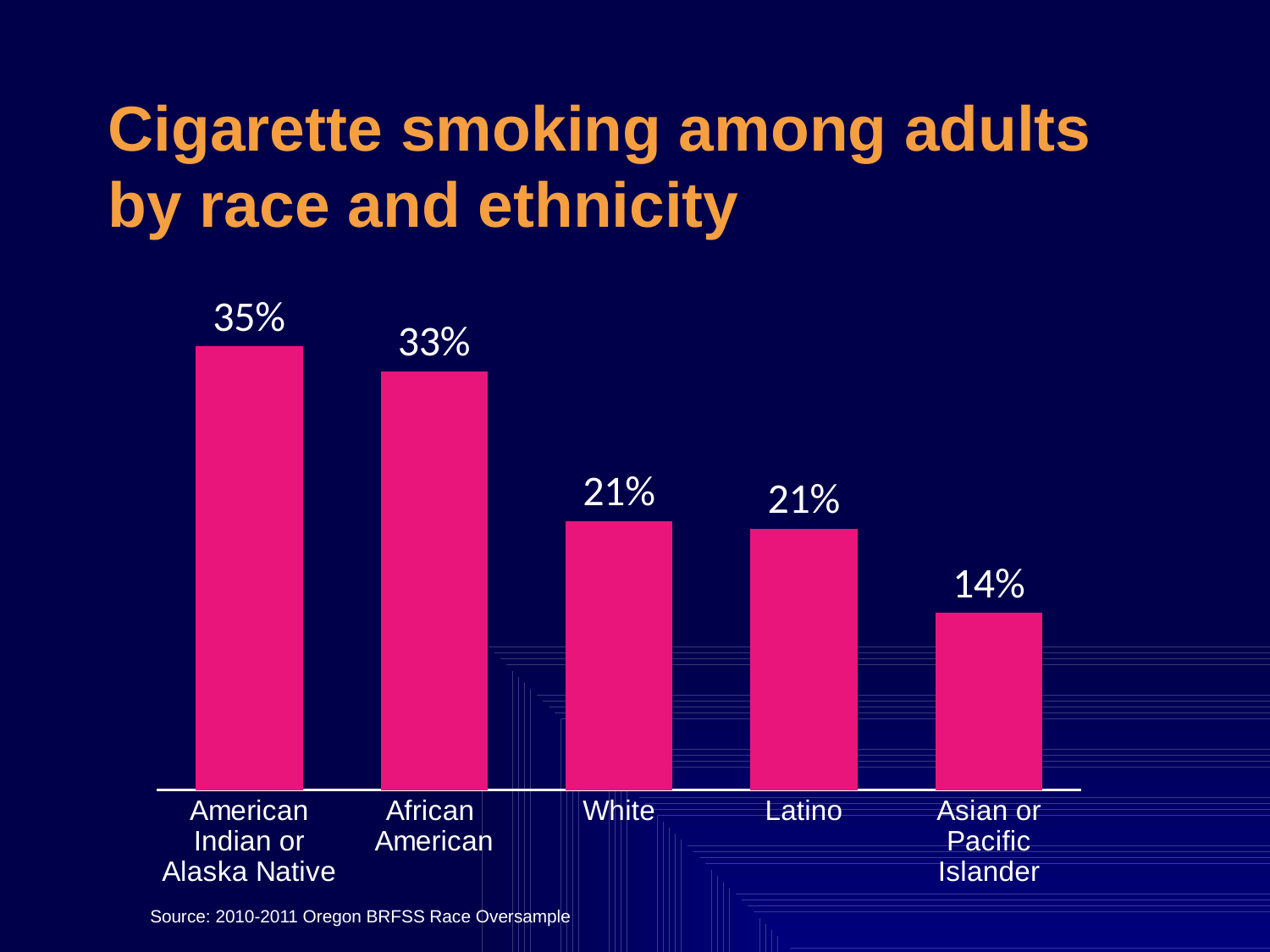
Which group has a higher smoking rate, African American or Latino? African American What kind of chart is shown on the slide? Bar chart What is the cigarette smoking rate for African American adults? 33% What is the source cited for the chart data? 2010-2011 Oregon BRFSS Race Oversample What is the cigarette smoking rate for American Indian or Alaska Native adults? 35% How many race and ethnicity groups are shown in the chart? 5 What is the difference in smoking rate between American Indian or Alaska Native adults and Asian or Pacific Islander adults? 21% Which race or ethnicity group has the highest cigarette smoking rate? American Indian or Alaska Native Which race or ethnicity group has the lowest cigarette smoking rate? Asian or Pacific Islander What is the difference in smoking rate between African American adults and White adults? 12% What is the cigarette smoking rate for Asian or Pacific Islander adults? 14% What is the cigarette smoking rate for Latino adults? 21%